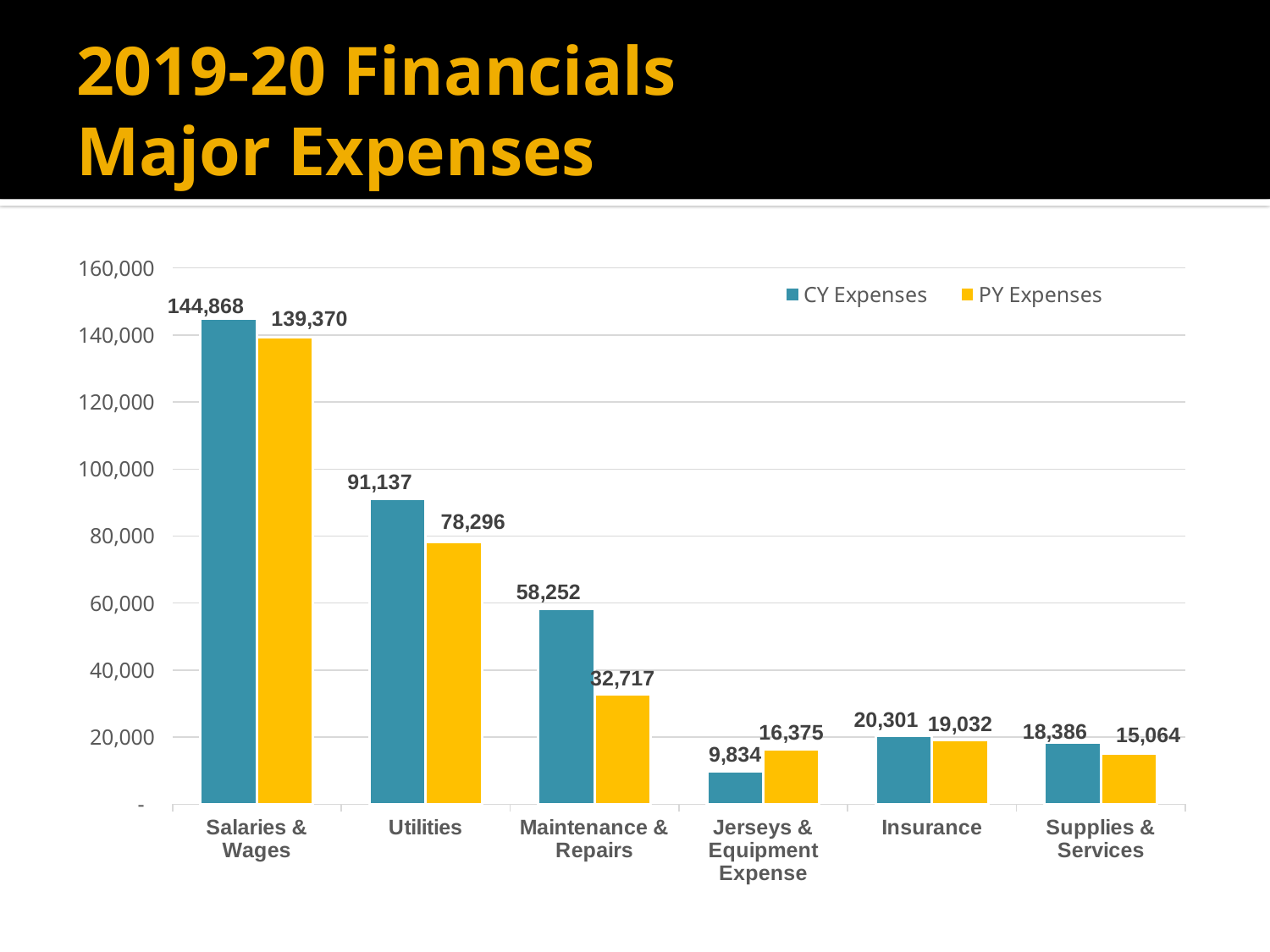
How many series does the legend list? 2 How many expense categories are shown on the x axis? 6 Which category has the lowest CY Expenses? Jerseys & Equipment Expense Which colour represents PY Expenses in the chart? Yellow What is the difference between CY Expenses and PY Expenses for Maintenance & Repairs? 25,535 Which category has the highest CY Expenses? Salaries & Wages For Jerseys & Equipment Expense, which is larger: CY Expenses or PY Expenses? PY Expenses Is the CY Expenses value for Utilities greater or less than 80,000? greater What is the CY Expenses value for Jerseys & Equipment Expense? 9,834 What kind of chart is shown on the slide? Bar chart What is the CY Expenses value for Salaries & Wages? 144,868 What is the PY Expenses value for Utilities? 78,296